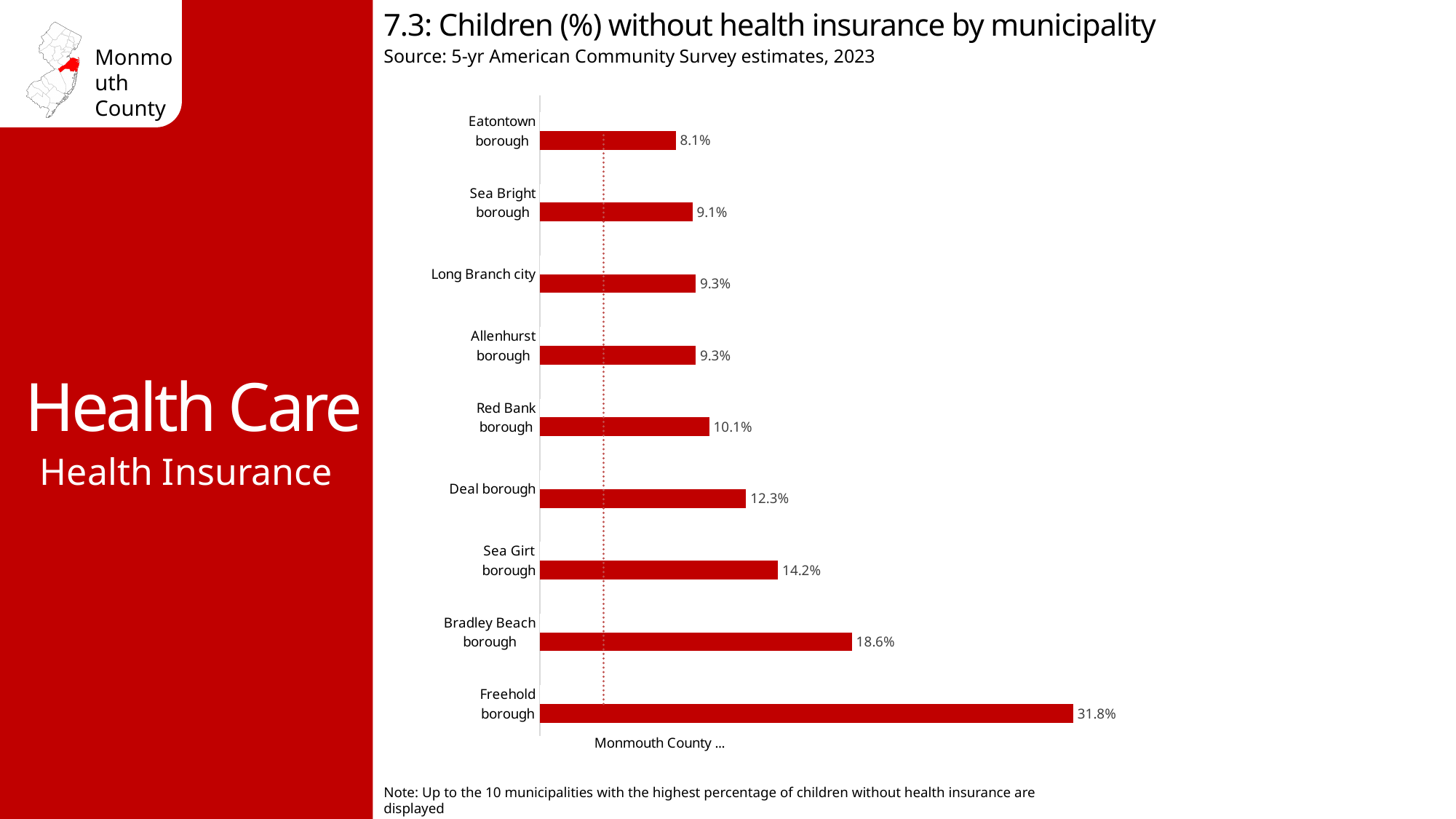
Which municipality has the lowest percentage of children without health insurance? Eatontown borough What is the difference between the values for Deal borough and Eatontown borough? 4.2% What is the source of the data shown in the chart? 5-yr American Community Survey estimates, 2023 What is the difference between the values for Freehold borough and Bradley Beach borough? 13.2% What is the value shown for Sea Girt borough? 14.2% What is the value shown for Red Bank borough? 10.1% What percentage of children are without health insurance in Freehold borough? 31.8% What type of chart is shown on the slide? Bar chart Which municipality has the highest percentage of children without health insurance? Freehold borough How many municipalities are shown in the chart? 9 Which has a higher value, Sea Girt borough or Deal borough? Sea Girt borough Which has a higher value, Sea Bright borough or Red Bank borough? Red Bank borough